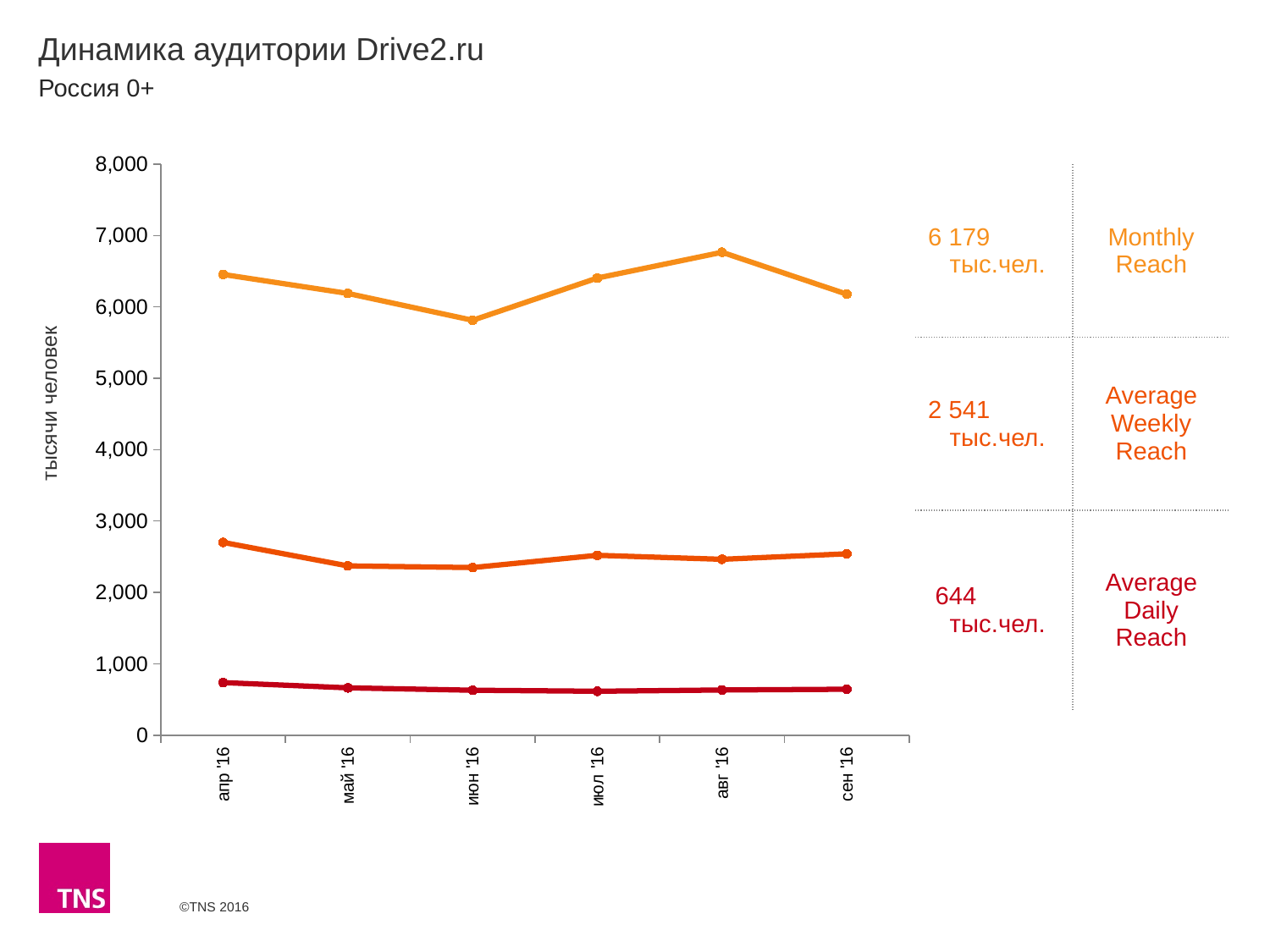
Is the Average Daily Reach value for апр '16 greater or less than 1,000? less Is the Monthly Reach value for авг '16 greater or less than 6,500? greater What kind of chart is shown on the slide? line chart Is the Average Weekly Reach value for май '16 greater or less than 2,500? less In which month does the Monthly Reach line reach its highest point? авг '16 In which month does the Monthly Reach line reach its lowest point? июн '16 What Monthly Reach figure is printed in the panel to the right of the chart? 6 179 тыс.чел. Does the Monthly Reach line rise or fall from апр '16 to июн '16? fall Which is larger, the Monthly Reach for авг '16 or for сен '16? авг '16 How many months are plotted along the x axis of the chart? 6 What is the label on the vertical axis of the chart? тысячи человек